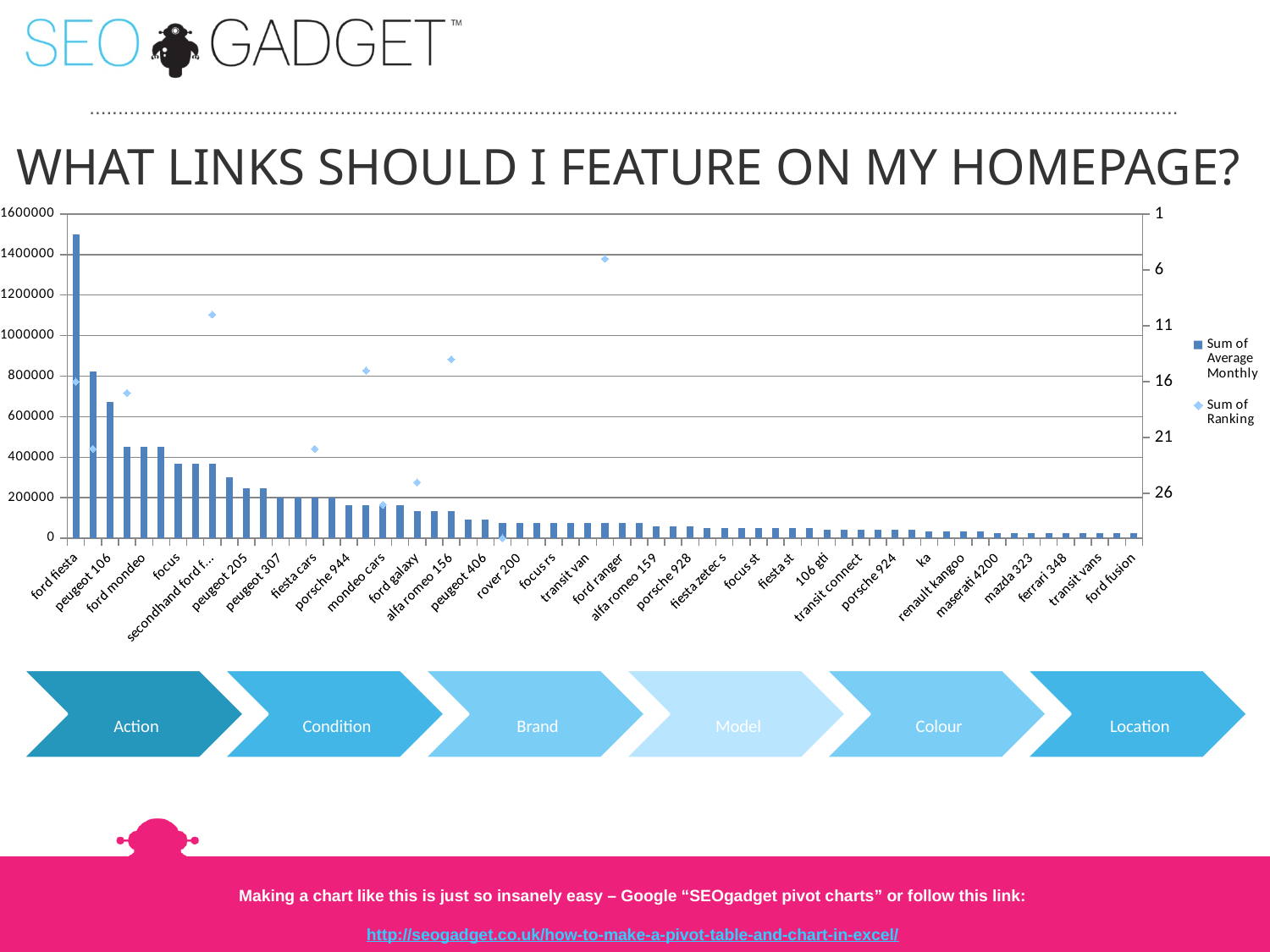
What kind of chart is used to show the Sum of Average Monthly series? Bar chart Is the Sum of Average Monthly value for ford fusion greater or less than 200000? less What is the highest tick value shown on the left-hand vertical axis? 1600000 Is the Sum of Ranking value for ford fiesta greater or less than 11? greater Which has the larger Sum of Average Monthly bar, ford fiesta or ford fusion? ford fiesta What are the two series named in the chart legend? Sum of Average Monthly and Sum of Ranking How many series does the chart legend list? 2 Is the Sum of Average Monthly value for ford fiesta greater or less than 1400000? greater Do the Sum of Average Monthly bars generally rise or fall from left to right along the x axis? fall Which category has the highest Sum of Average Monthly bar? ford fiesta